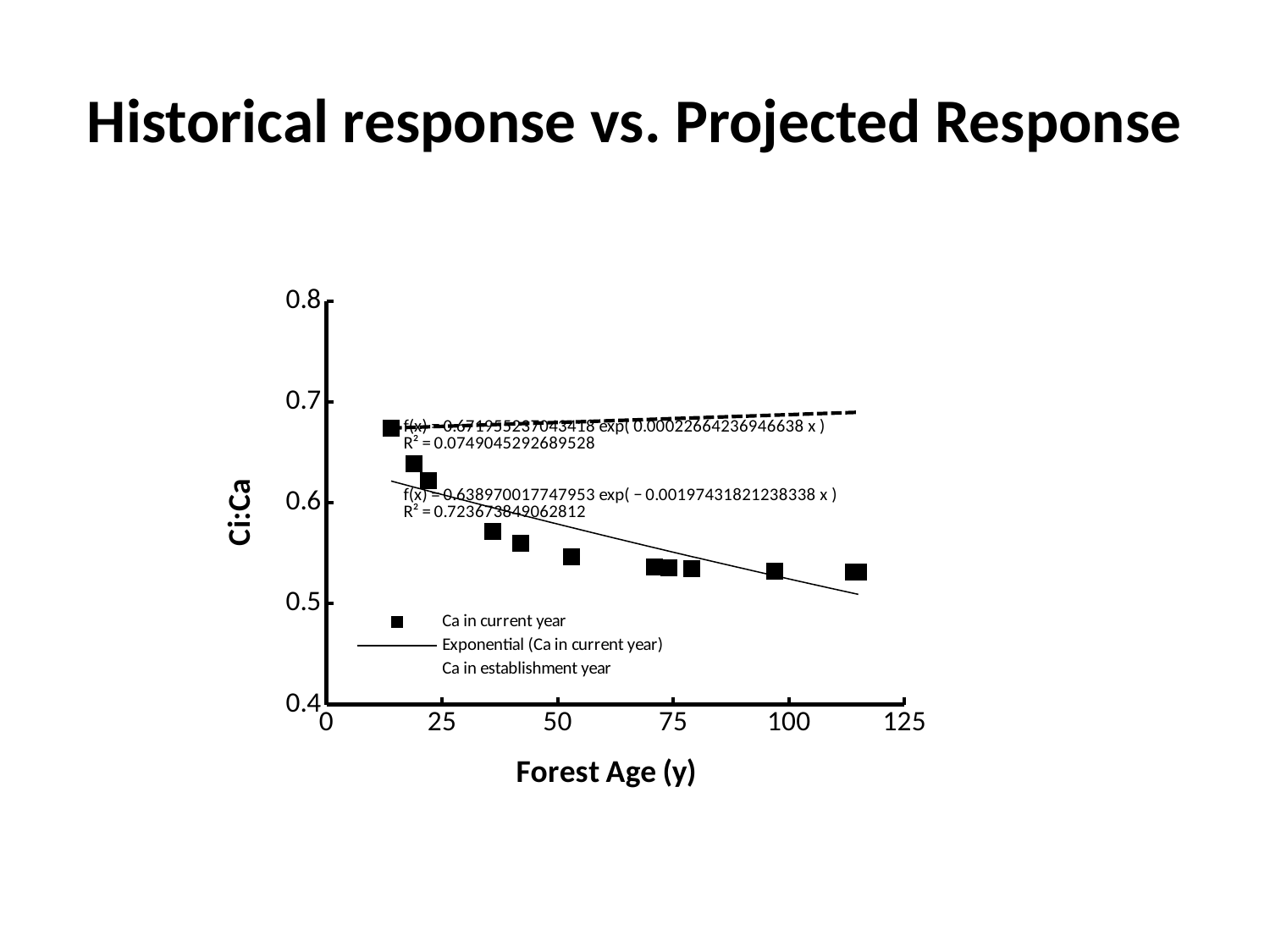
Is the Ca in establishment year line greater or less than 0.6 across the plotted range? greater At a forest age of about 100 y, which is higher: the Ca in establishment year line or the Ca in current year point? Ca in establishment year What kind of chart is shown on the slide? scatter chart How many entries does the chart legend list? 3 Is the highest Ci:Ca value among the Ca in current year points found at the youngest or the oldest forest age? youngest What is the title of the slide's chart? Historical response vs. Projected Response What R² value is printed for the fit with the equation containing exp( 0.000226642369466638 x )? 0.0749045292689528 What is the label of the x axis? Forest Age (y) What R² value is printed for the exponential fit with the equation f(x) = 0.638970017747953 exp( − 0.00197431821238338 x )? 0.723673849062812 Do the Ca in current year values rise or fall as forest age increases? fall Is the Ci:Ca value for the youngest forest (around 14 y) greater or less than 0.6? greater